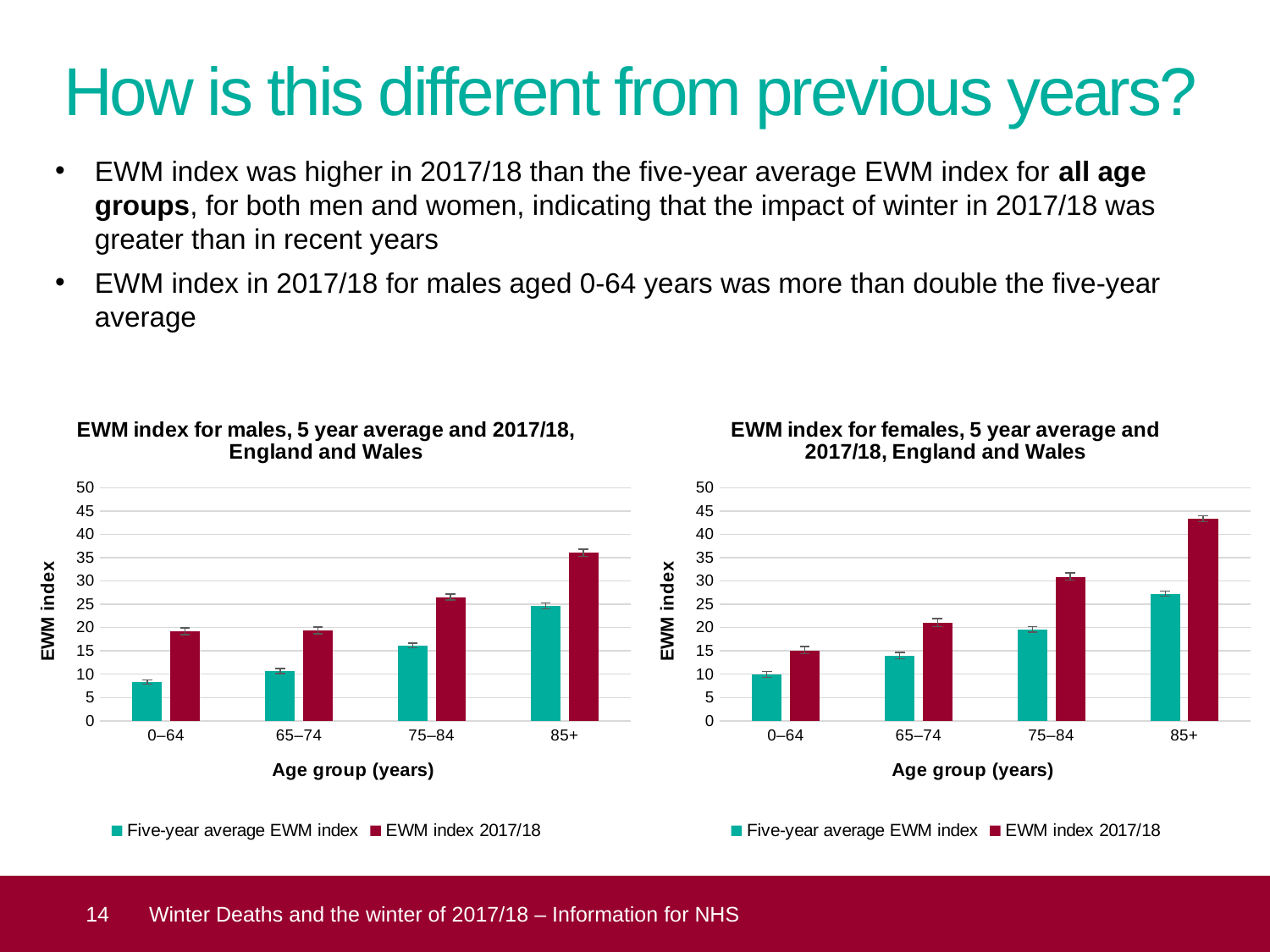
How many series does the legend of the 'EWM index for males' chart list? 2 In the 'EWM index for females' chart, is the EWM index 2017/18 for the 85+ age group greater or less than 40? greater In the 'EWM index for females' chart, which age group has the highest five-year average EWM index? 85+ In the 'EWM index for males' chart, which age group has the highest EWM index 2017/18? 85+ In the 'EWM index for females' chart, is the EWM index 2017/18 for the 75–84 age group greater or less than 25? greater How many age groups are shown on the x axis of the 'EWM index for females' chart? 4 In the 'EWM index for males' chart, is the five-year average EWM index for the 0–64 age group greater or less than 10? less In the 'EWM index for males' chart, which is larger for the 75–84 age group: the five-year average EWM index or the EWM index 2017/18? EWM index 2017/18 What is the label of the y axis on the 'EWM index for males' chart? EWM index What type of chart is the 'EWM index for males' chart? bar chart In the 'EWM index for females' chart, does the five-year average EWM index rise or fall as age group increases along the x axis? rise In the 'EWM index for males' chart, which age group has the lowest five-year average EWM index? 0–64